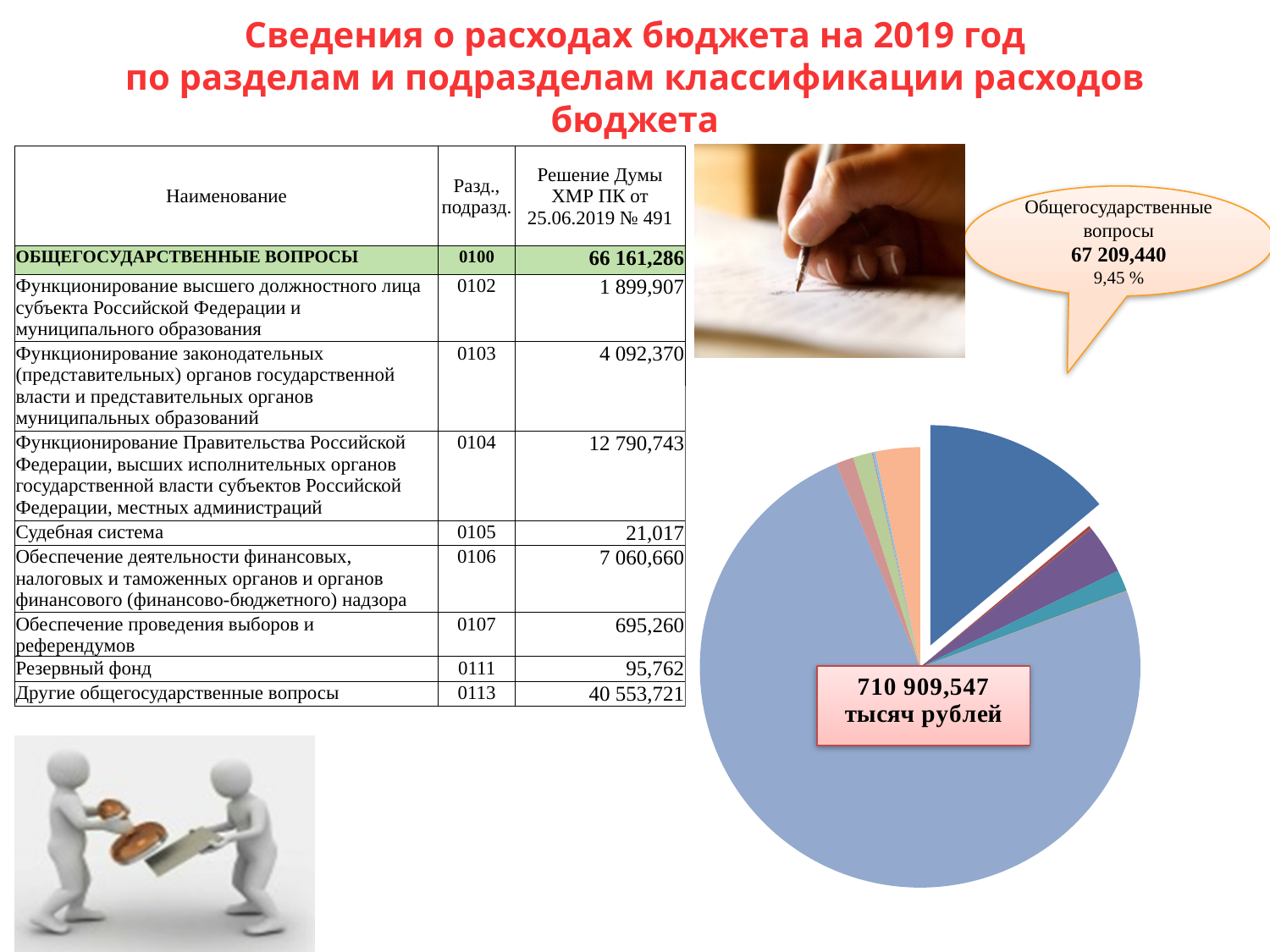
Is the Общегосударственные вопросы slice the largest slice of the pie chart? no Is the share of Общегосударственные вопросы in the pie chart greater or less than 10 %? less Does the pie chart have a legend? no According to the callout on the pie chart, what is the value for Общегосударственные вопросы? 67 209,440 Which slice of the pie chart is pulled out (exploded) from the rest? Общегосударственные вопросы What total amount is printed in the box over the pie chart? 710 909,547 тысяч рублей What kind of chart is shown on the right side of the slide? pie chart What share of the pie does the Общегосударственные вопросы slice represent, according to the callout? 9,45 %